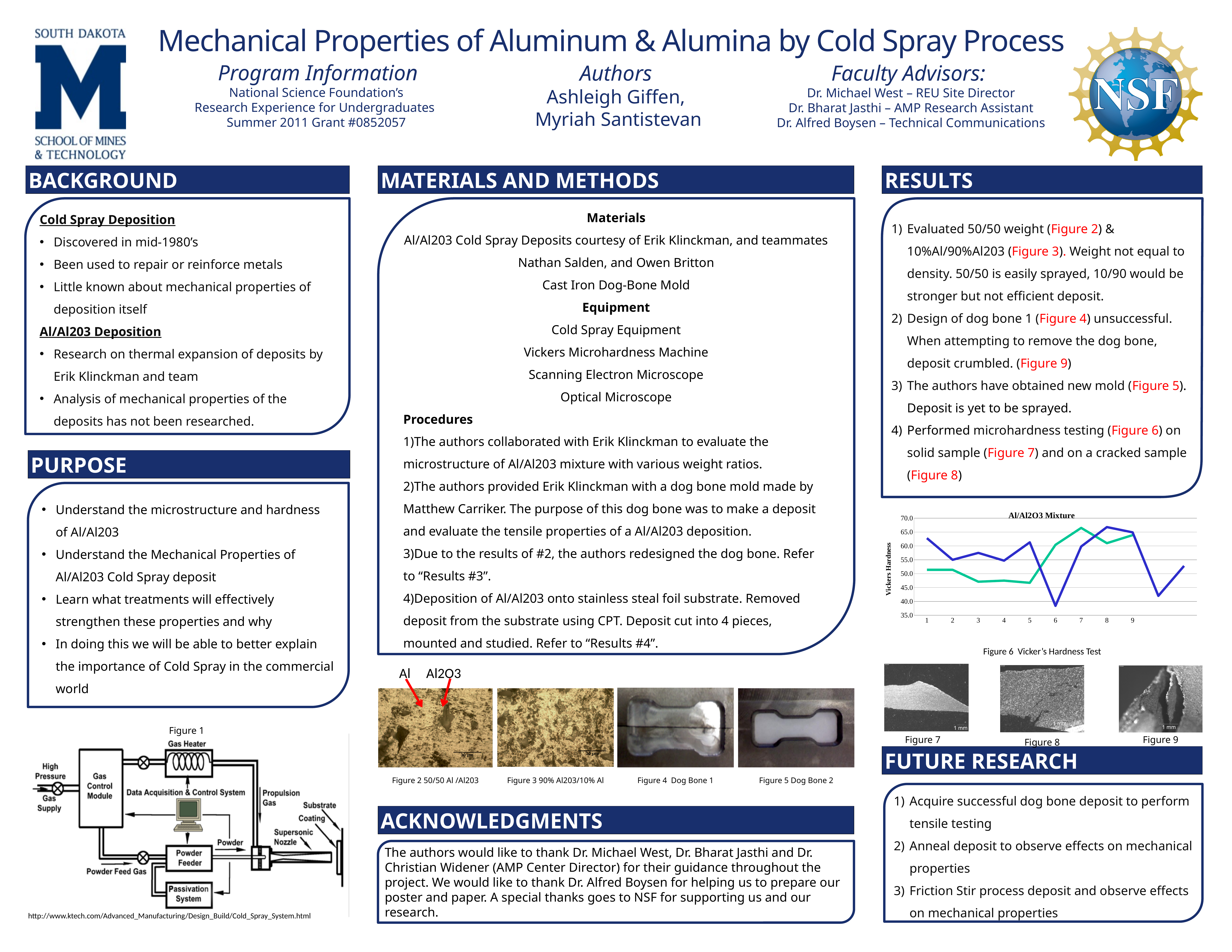
On the Al/Al2O3 Mixture chart, at x = 6, which line has the higher value, blue or green? green What kind of chart is the Al/Al2O3 Mixture chart? line chart What is the title of the chart in the Results section? Al/Al2O3 Mixture On the Al/Al2O3 Mixture chart, is the blue line's value at x = 8 greater or less than 60? greater On the Al/Al2O3 Mixture chart, at which x value does the blue line reach its lowest point? 6 How many lines are plotted on the Al/Al2O3 Mixture chart? 2 How many numbered tick labels are shown on the x axis of the Al/Al2O3 Mixture chart? 9 On the Al/Al2O3 Mixture chart, at x = 3, which line has the higher value, blue or green? blue On the Al/Al2O3 Mixture chart, is the blue line's value at x = 6 greater or less than 45? less What is the label on the y axis of the Al/Al2O3 Mixture chart? Vickers Hardness On the Al/Al2O3 Mixture chart, is the green line's value at x = 7 greater or less than 60? greater